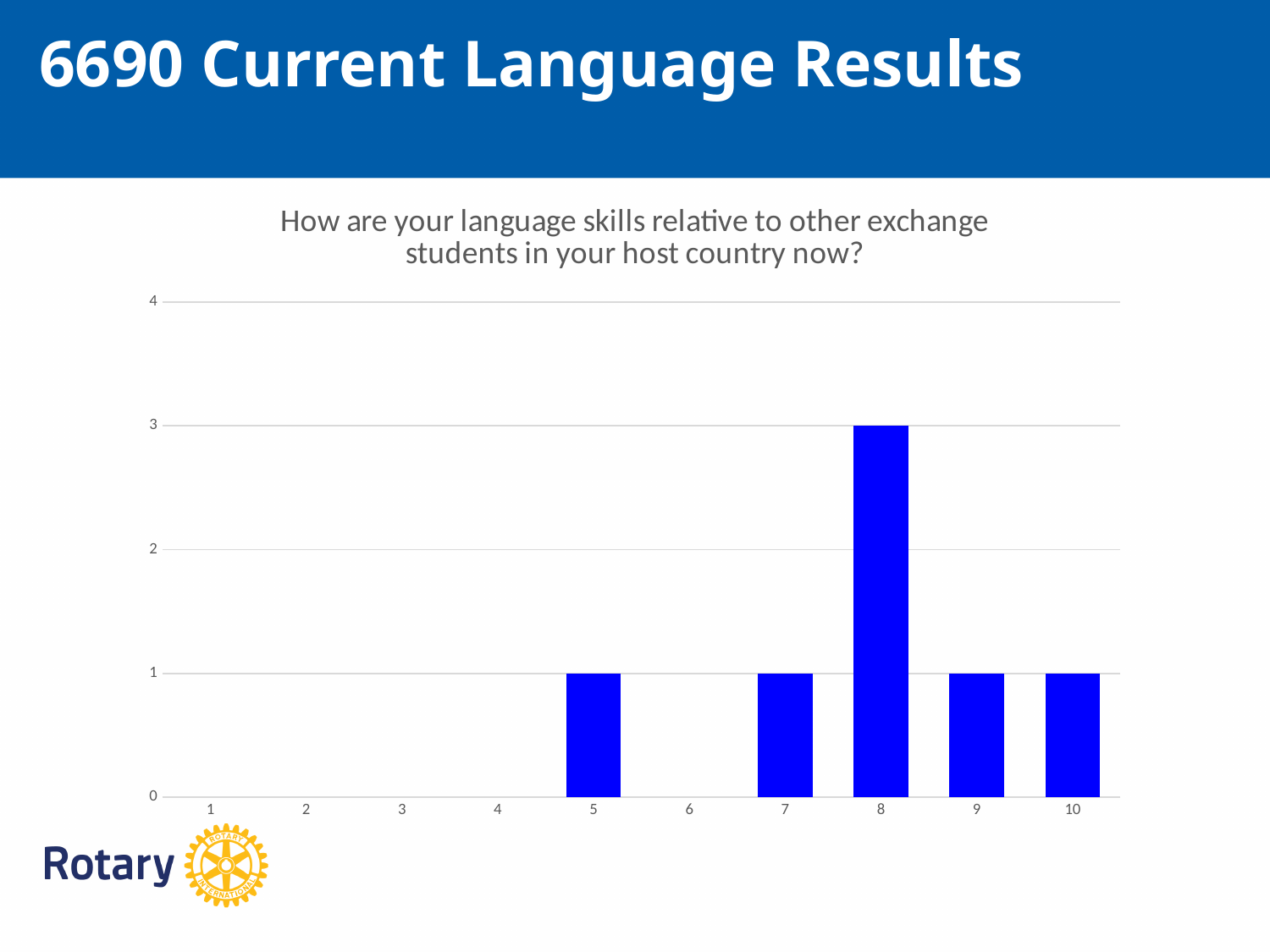
What kind of chart is shown on the slide? bar chart What is the value for category 9? 1 What is the title of the chart? How are your language skills relative to other exchange students in your host country now? How many categories are shown on the x axis? 10 What is the value for category 5? 1 Which is larger, the value for category 8 or the value for category 10? 8 Is the value for category 8 greater or less than 2? greater What is the value for category 6? 0 How many categories have a value of 1? 4 What is the difference between the values for category 8 and category 7? 2 Which category has the highest value? 8 What is the value for category 8? 3